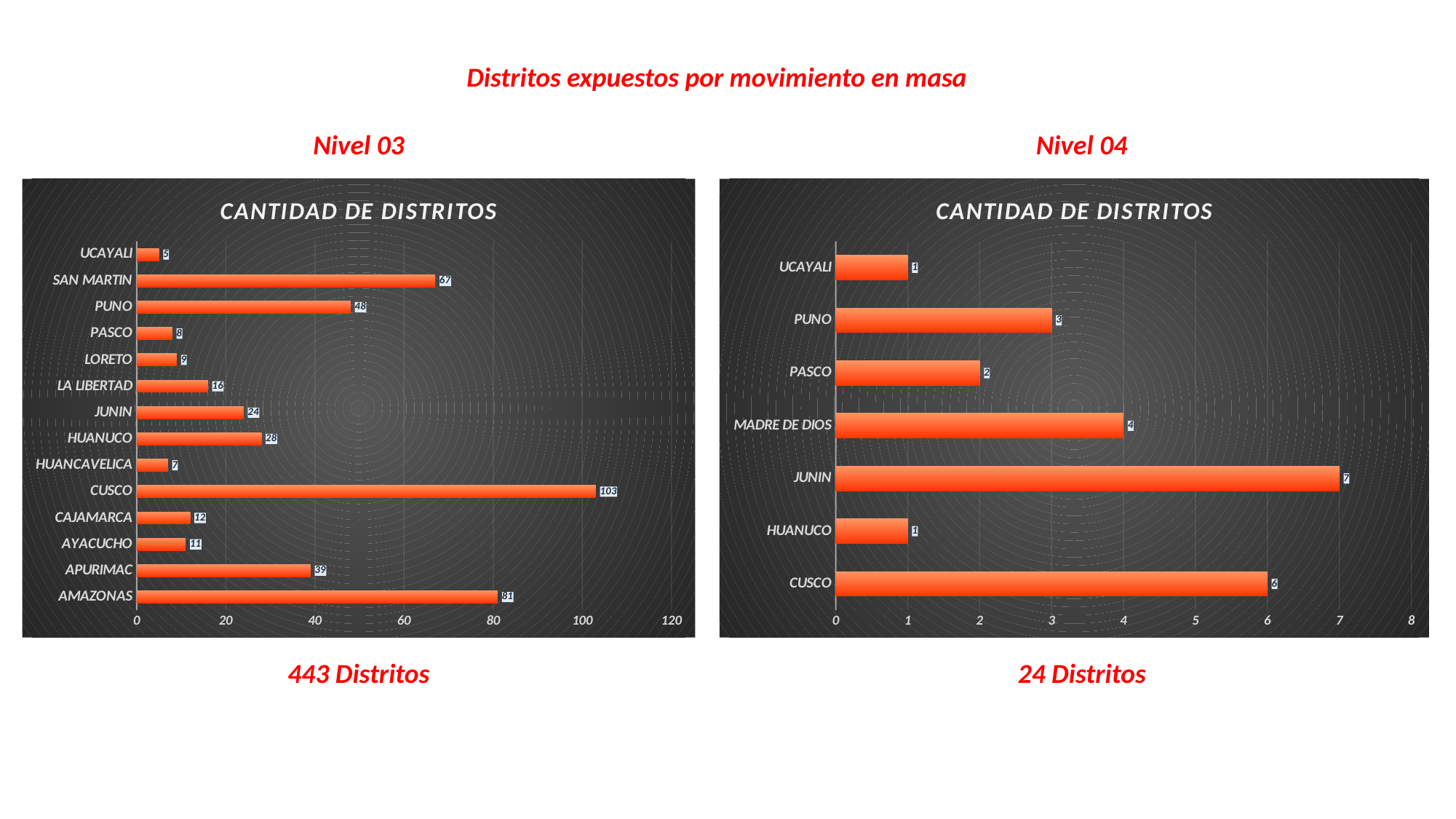
In the Nivel 03 chart (left), how many regions are shown? 14 In the Nivel 03 chart (left), which is larger, the value for HUANUCO or the value for JUNIN? HUANUCO In the Nivel 04 chart (right), what is the value for MADRE DE DIOS? 4 In the Nivel 04 chart (right), which region has the highest value? JUNIN In the Nivel 03 chart (left), which region has the highest value? CUSCO In the Nivel 04 chart (right), how many regions are shown? 7 In the Nivel 04 chart (right), what is the difference between the values for JUNIN and CUSCO? 1 In the Nivel 03 chart (left), what is the value for CUSCO? 103 What kind of chart is the Nivel 04 chart (right)? Bar chart In the Nivel 03 chart (left), what is the value for SAN MARTIN? 67 In the Nivel 03 chart (left), what is the difference between the values for AMAZONAS and APURIMAC? 42 In the Nivel 03 chart (left), which region has the lowest value? UCAYALI